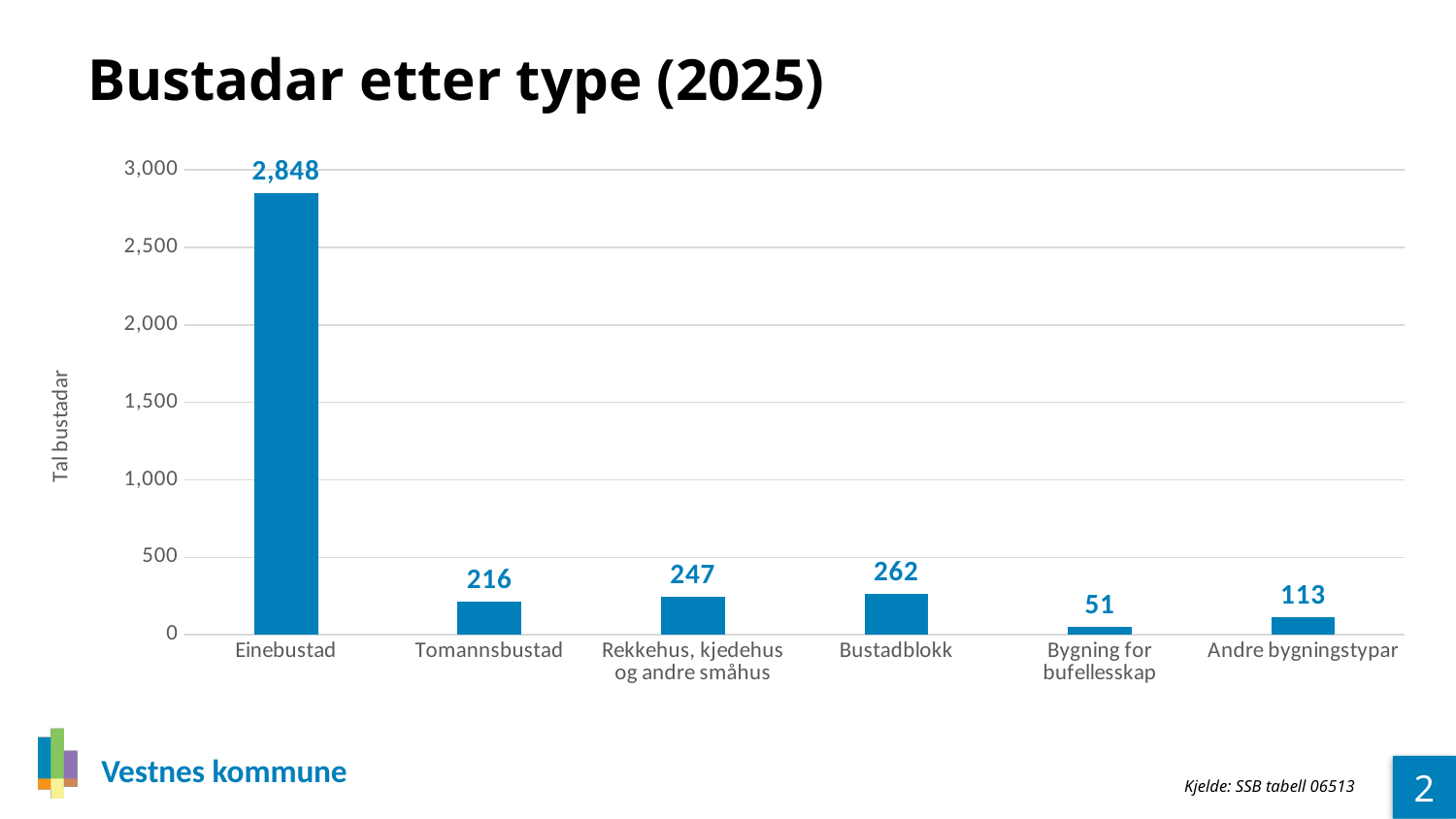
What kind of chart is shown on the slide? bar chart How many categories are shown on the x axis? 6 What is the value for Andre bygningstypar? 113 Which category has the lowest value? Bygning for bufellesskap What is the value for Bygning for bufellesskap? 51 What is the difference between the values for Bustadblokk and Tomannsbustad? 46 What is the title of the chart? Bustadar etter type (2025) Is the value for Bustadblokk greater or less than 500? less What is the value for Einebustad? 2,848 Which category has the highest value? Einebustad Which is larger, the value for Rekkehus, kjedehus og andre småhus or the value for Andre bygningstypar? Rekkehus, kjedehus og andre småhus What is the value for Tomannsbustad? 216